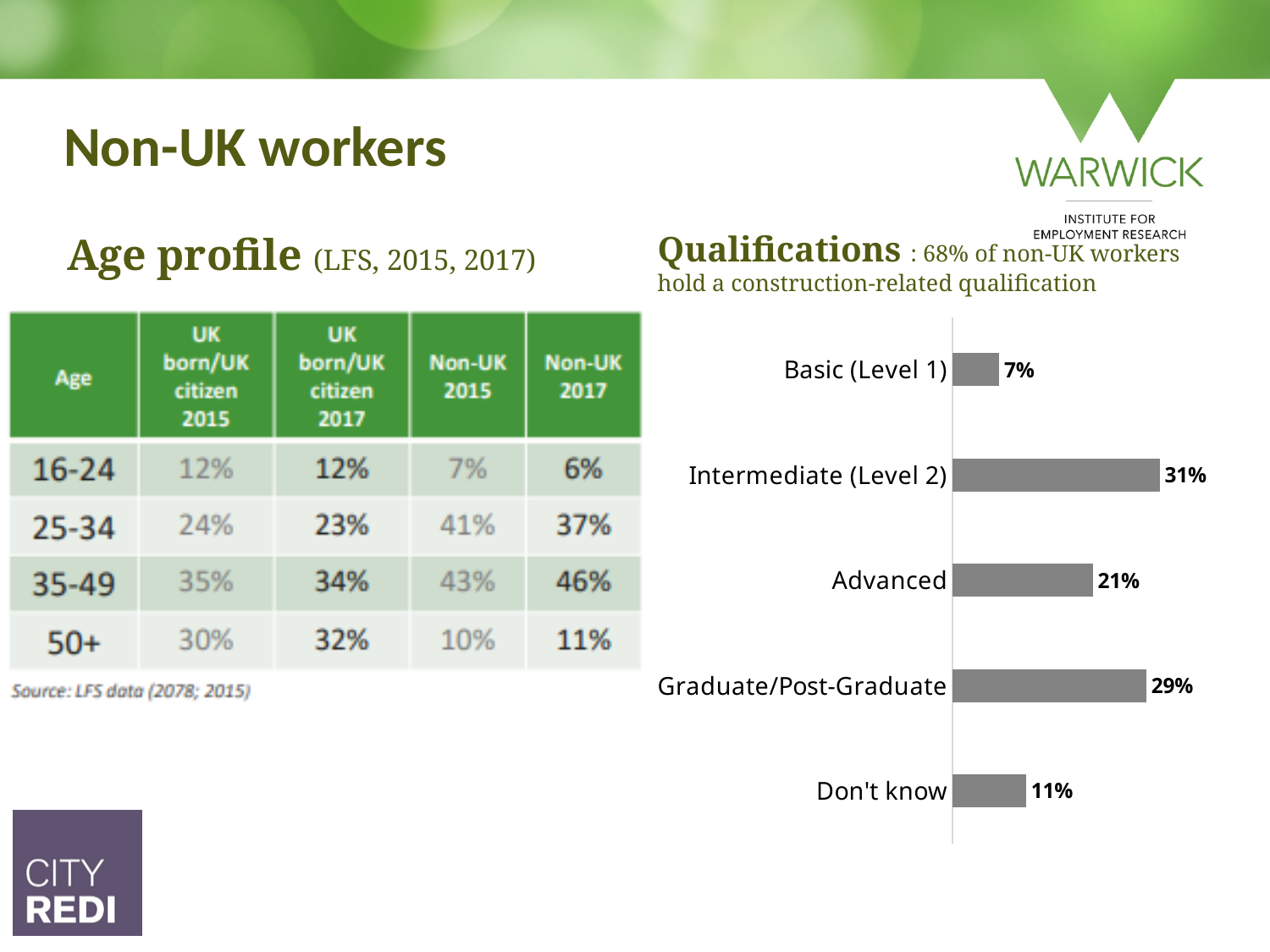
How many categories does the Qualifications bar chart show? 5 In the Qualifications bar chart, what is the difference between Intermediate (Level 2) and Advanced? 10% In the Qualifications bar chart, what is the value for Intermediate (Level 2)? 31% In the Qualifications bar chart, what is the value for Don't know? 11% In the Qualifications bar chart, which category has the highest value? Intermediate (Level 2) In the Qualifications bar chart, which category has the lowest value? Basic (Level 1) In the Qualifications bar chart, what is the value for Graduate/Post-Graduate? 29% In the Qualifications bar chart, what is the value for Basic (Level 1)? 7% What kind of chart is the Qualifications chart? Bar chart In the Qualifications bar chart, which is larger: Advanced or Graduate/Post-Graduate? Graduate/Post-Graduate In the Qualifications bar chart, what is the difference between Graduate/Post-Graduate and Don't know? 18% In the Qualifications bar chart, which is larger: Basic (Level 1) or Don't know? Don't know